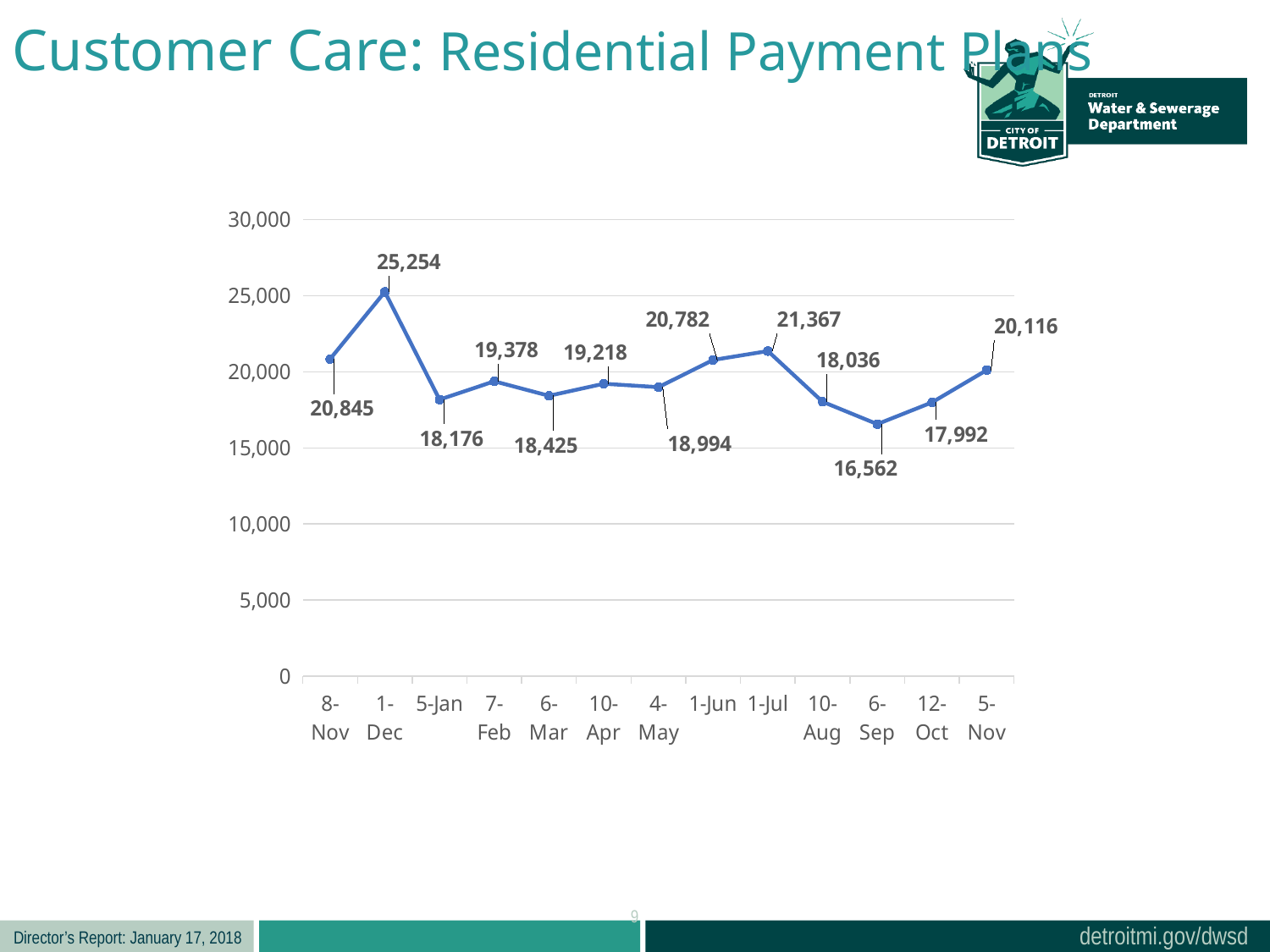
Which is larger, the value for 7-Feb or the value for 6-Mar? 7-Feb What is the value for 6-Sep? 16,562 What is the difference between the values for 1-Jul and 10-Aug? 3,331 Which date has the lowest value? 6-Sep What is the difference between the values for 1-Dec and 5-Jan? 7,078 What is the value for 5-Nov? 20,116 What is the value for 1-Dec? 25,254 Which date has the highest value? 1-Dec What type of chart is shown on the slide? Line chart How many data points are plotted on the chart? 13 What is the value for 1-Jul? 21,367 Does the value rise or fall from 6-Sep to 5-Nov? Rise